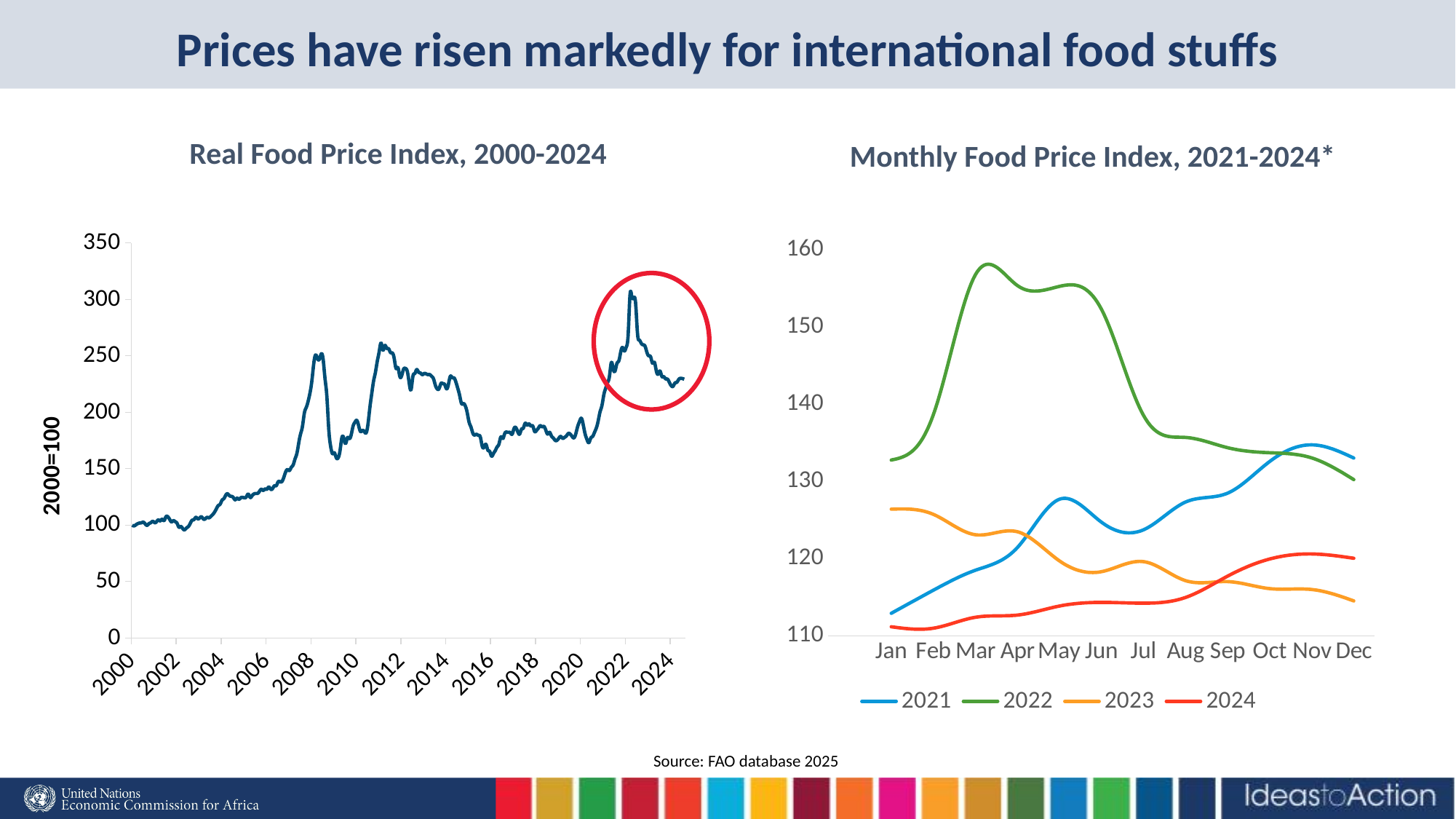
In the 'Monthly Food Price Index, 2021-2024*' chart, which year's series reaches the highest value? 2022 In the 'Real Food Price Index, 2000-2024' chart, is the peak value around 2022 greater or less than 250? greater What kind of chart is the 'Real Food Price Index, 2000-2024' chart? line chart What is the y-axis label of the 'Real Food Price Index, 2000-2024' chart? 2000=100 How many series does the legend of the 'Monthly Food Price Index, 2021-2024*' chart list? 4 In the 'Monthly Food Price Index, 2021-2024*' chart, is the 2022 value for March greater or less than 150? greater How many months are shown on the x axis of the 'Monthly Food Price Index, 2021-2024*' chart? 12 In the 'Monthly Food Price Index, 2021-2024*' chart, which is larger in December: the 2021 value or the 2023 value? 2021 In the 'Monthly Food Price Index, 2021-2024*' chart, does the 2022 series rise or fall from June to December? fall In the 'Real Food Price Index, 2000-2024' chart, is the value in 2016 greater or less than 200? less In the 'Monthly Food Price Index, 2021-2024*' chart, which year's series has the lowest value in January? 2024